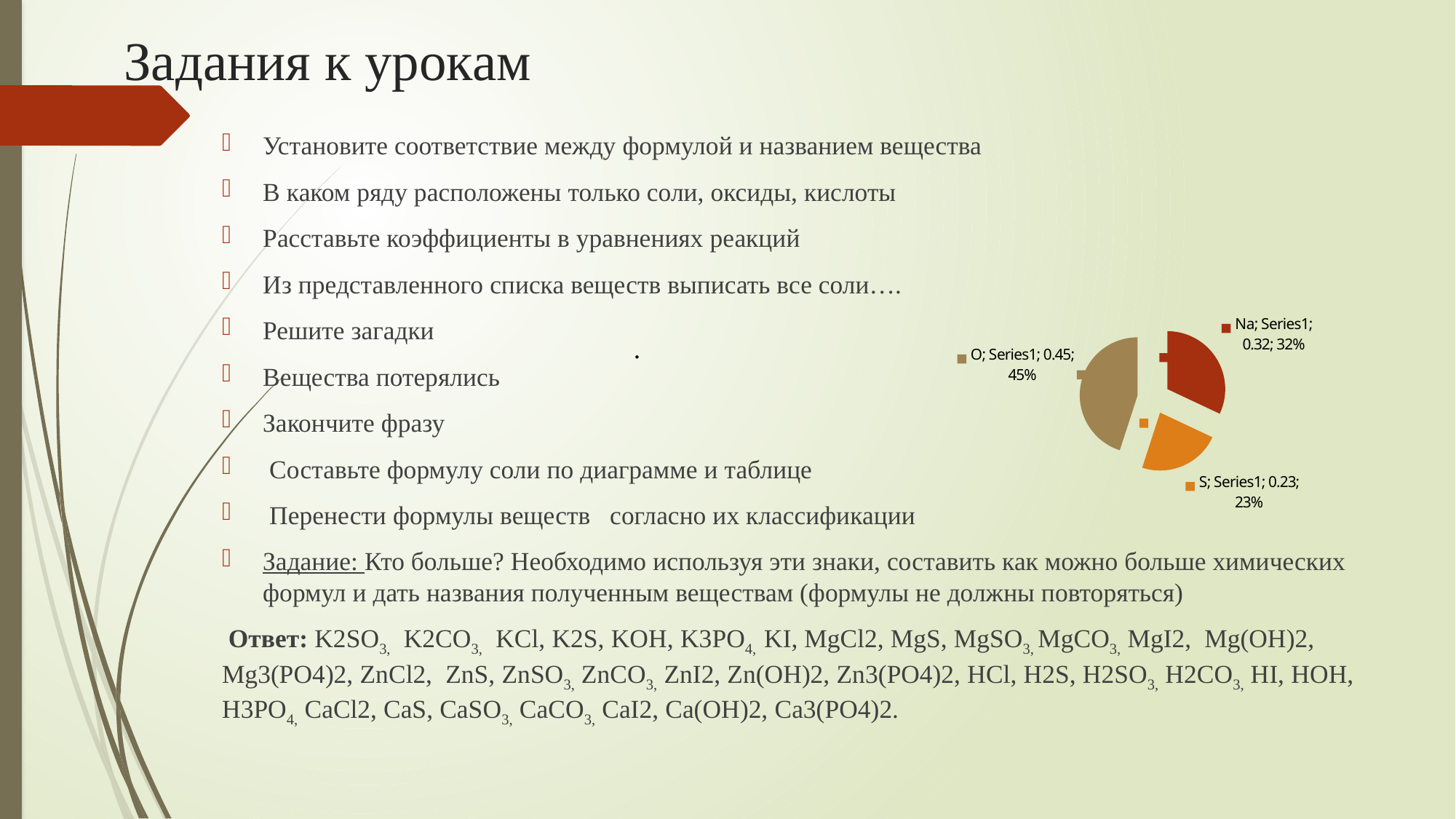
What is the difference between the percentage shares of O and S? 22% Which element has the smallest slice in the pie chart? S What share of the pie does O represent? 45% What is the value shown for Na in the pie chart? 0.32 How many slices does the pie chart have? 3 What share of the pie does S represent? 23% What is the value shown for O in the pie chart? 0.45 What kind of chart is shown on the slide? pie chart Which slice is larger, Na or S? Na What series name is shown in the pie chart's data labels? Series1 What is the value shown for S in the pie chart? 0.23 Which element has the largest slice in the pie chart? O